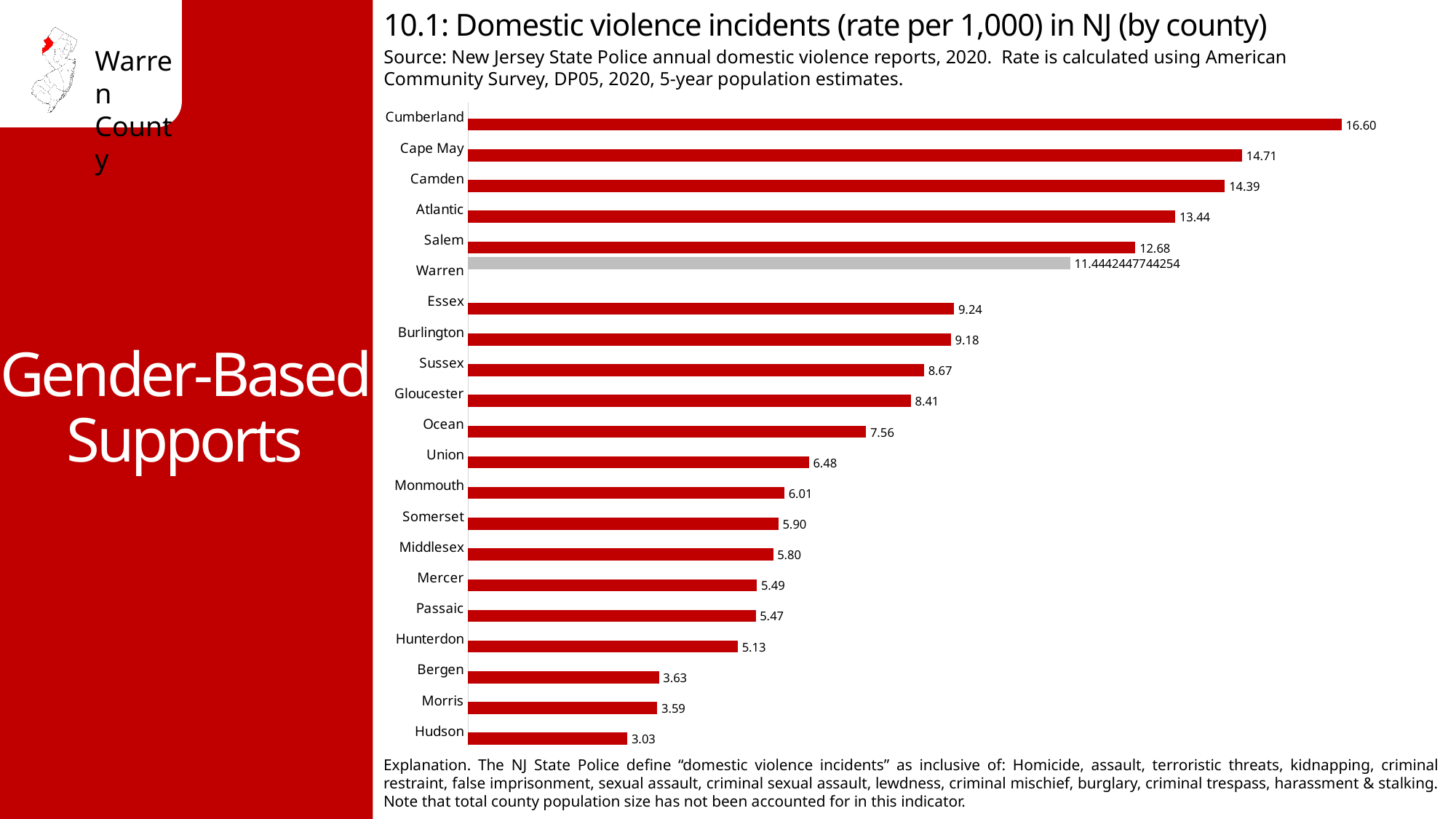
What is the difference between the rates for Cape May and Camden? 0.32 Which county has the highest domestic violence incident rate? Cumberland What value is shown for Warren County? 11.4442447744254 What kind of chart is used to show the domestic violence incident rates? Bar chart What is the domestic violence incident rate per 1,000 for Cumberland County? 16.60 Which county has the lowest domestic violence incident rate? Hudson Which county has a higher rate, Essex or Ocean? Essex Which county's bar is shown in gray rather than red? Warren What is the difference between the rates for Cumberland and Hudson? 13.57 What is the rate shown for Hudson County? 3.03 How many counties are shown in the chart? 21 Which county has a higher rate, Salem or Union? Salem